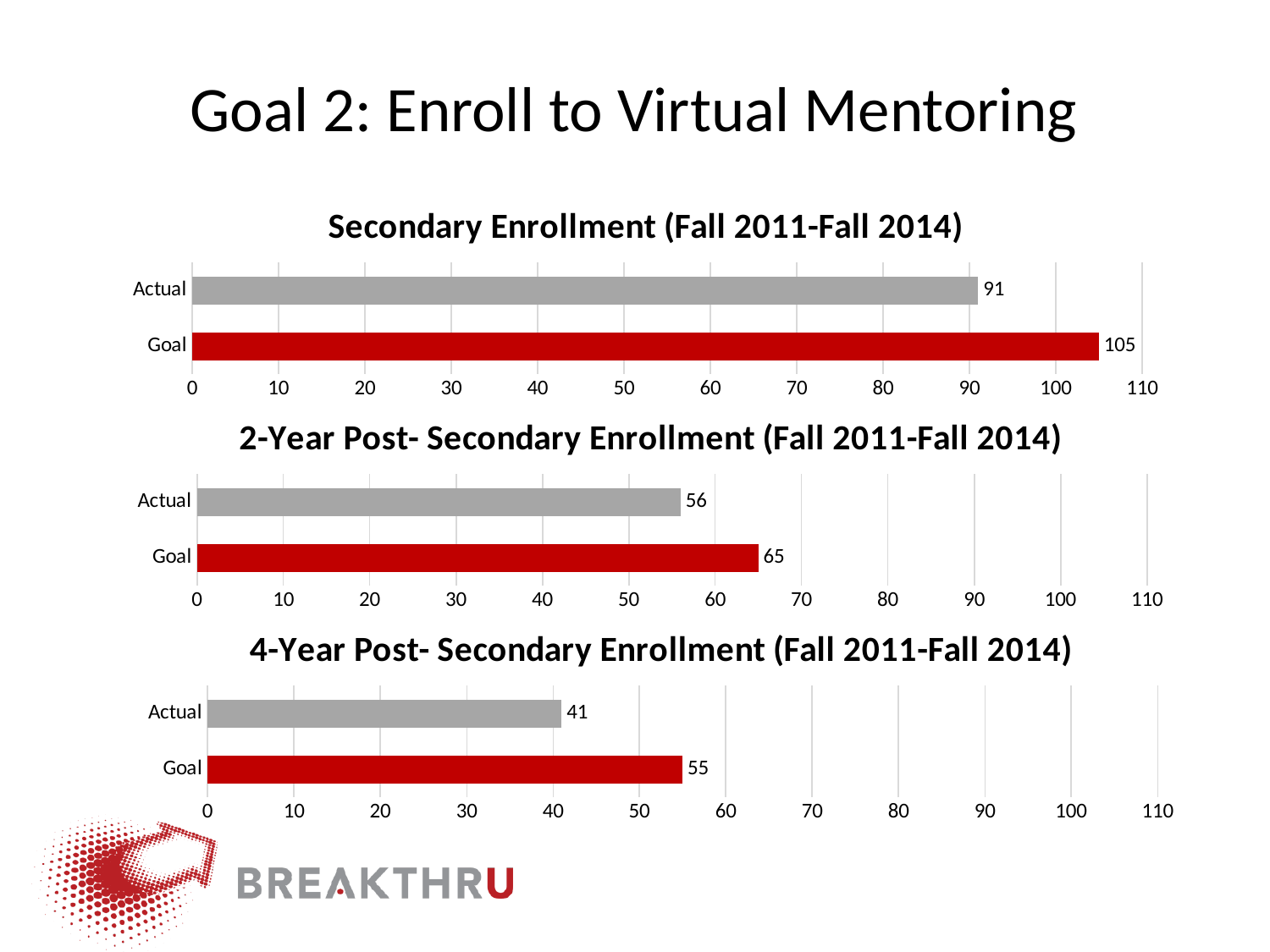
In the 2-Year Post- Secondary Enrollment (Fall 2011-Fall 2014) chart, what is the difference between Goal and Actual? 9 In the 4-Year Post- Secondary Enrollment (Fall 2011-Fall 2014) chart, what is the difference between Goal and Actual? 14 How many categories are shown in the 4-Year Post- Secondary Enrollment (Fall 2011-Fall 2014) chart? 2 In the 4-Year Post- Secondary Enrollment (Fall 2011-Fall 2014) chart, which is larger, Actual or Goal? Goal In the Secondary Enrollment (Fall 2011-Fall 2014) chart, what is the value for Goal? 105 In the 2-Year Post- Secondary Enrollment (Fall 2011-Fall 2014) chart, which category has the lowest value? Actual In the 4-Year Post- Secondary Enrollment (Fall 2011-Fall 2014) chart, what is the value for Goal? 55 In the Secondary Enrollment (Fall 2011-Fall 2014) chart, what is the difference between Goal and Actual? 14 What kind of chart is the Secondary Enrollment (Fall 2011-Fall 2014) chart? Bar chart In the 2-Year Post- Secondary Enrollment (Fall 2011-Fall 2014) chart, what is the value for Actual? 56 How many charts are shown on the slide? 3 In the Secondary Enrollment (Fall 2011-Fall 2014) chart, what is the value for Actual? 91